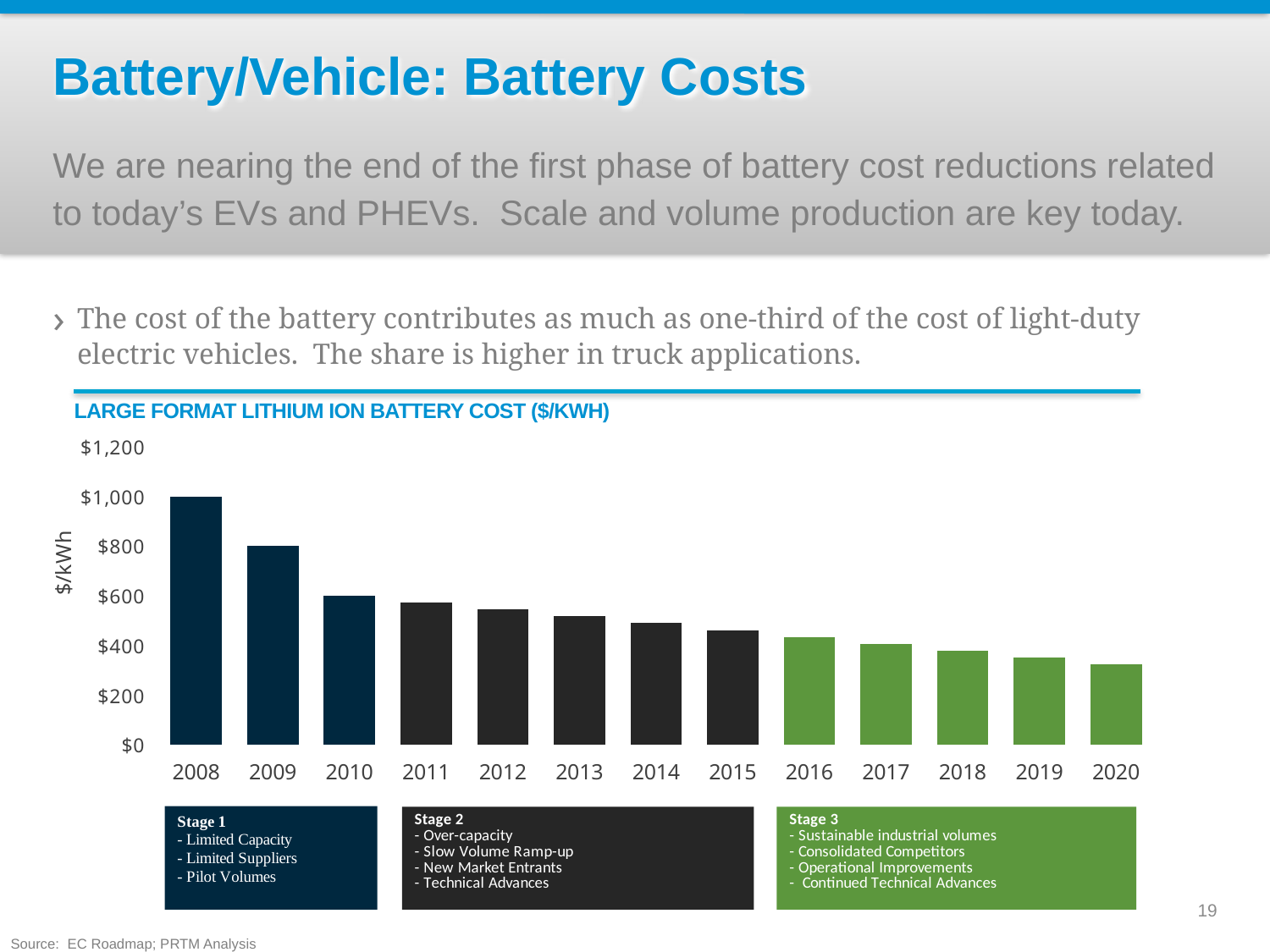
Is the value for 2013 greater or less than $600? less Is the value for 2015 greater or less than $400? greater How many years are plotted on the x axis of the chart? 13 Is the value for 2020 greater or less than $400? less What label is shown on the y axis of the chart? $/kWh Which year has the highest battery cost in the chart? 2008 Which year has the lowest battery cost in the chart? 2020 What kind of chart is shown on the slide? bar chart What is the title of the chart? LARGE FORMAT LITHIUM ION BATTERY COST ($/KWH) Which is larger, the value for 2009 or the value for 2014? 2009 Do the battery cost values rise or fall from 2008 to 2020? fall